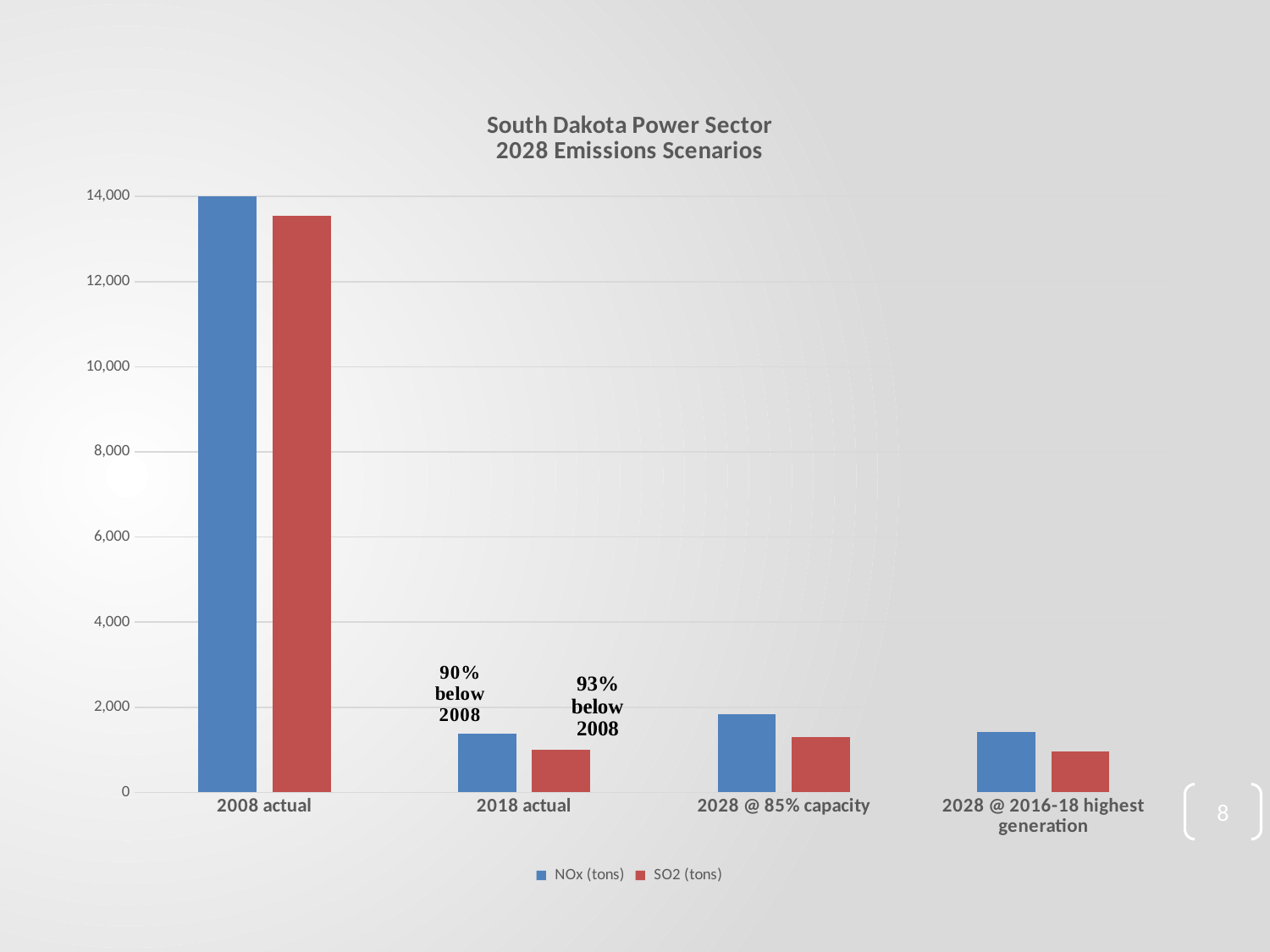
Which category has the highest SO2 (tons) value? 2008 actual Which category has the highest NOx (tons) value? 2008 actual For 2028 @ 85% capacity, which is larger: NOx (tons) or SO2 (tons)? NOx (tons) Is the SO2 (tons) value for 2008 actual greater or less than 12,000? greater For 2008 actual, which is larger: NOx (tons) or SO2 (tons)? NOx (tons) Does the NOx (tons) value rise or fall from 2008 actual to 2018 actual? fall Is the NOx (tons) value for 2018 actual greater or less than 2,000? less What is the title of the chart? South Dakota Power Sector 2028 Emissions Scenarios What kind of chart is shown on the slide? Bar chart How many categories are shown on the x axis of the chart? 4 How many series does the legend list? 2 What annotation is printed above the SO2 (tons) bar for 2018 actual? 93% below 2008